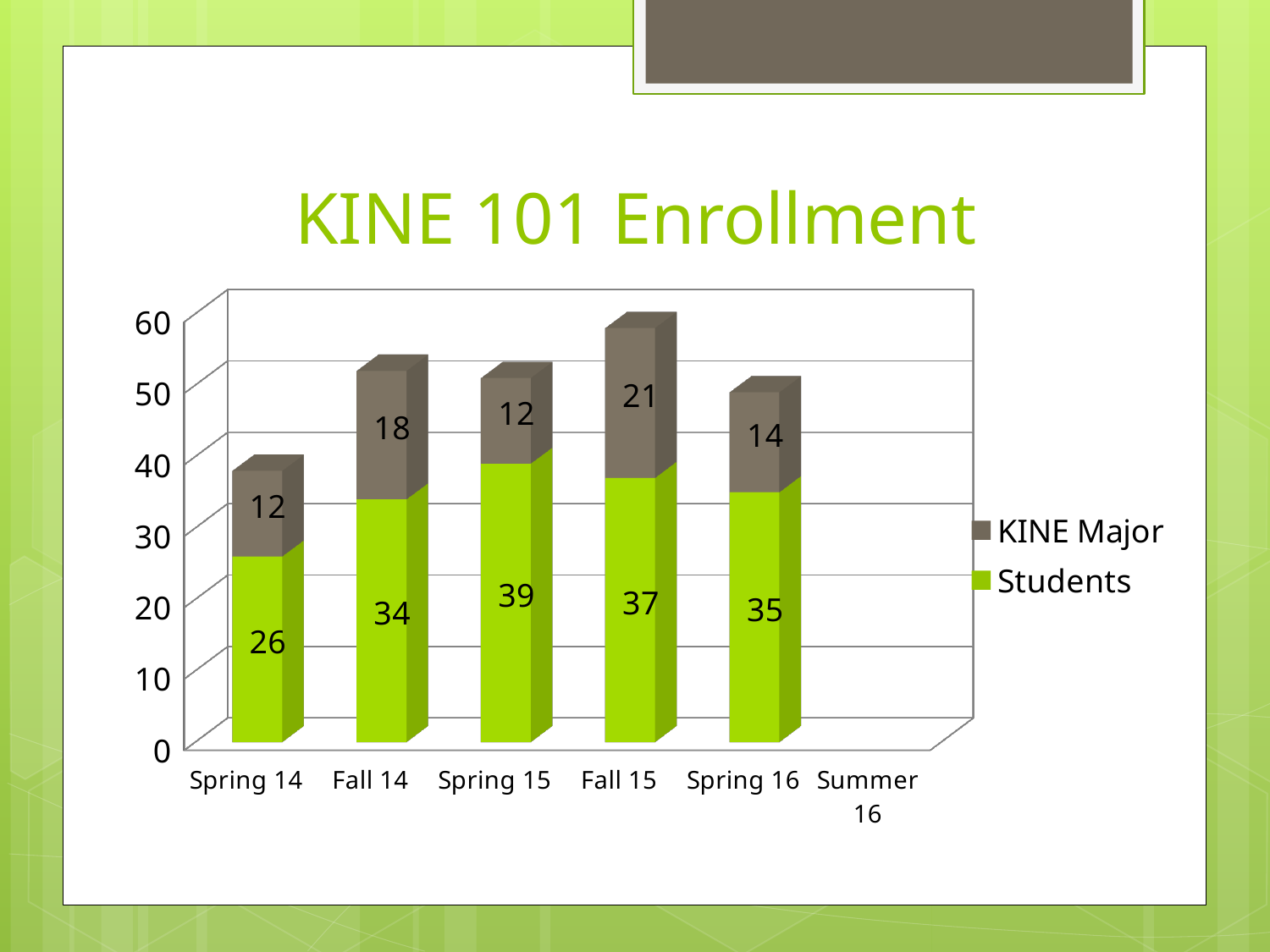
What is the total of the stacked bar for Fall 15? 58 What is the title of the chart? KINE 101 Enrollment What is the difference between the KINE Major values for Fall 15 and Spring 16? 7 Which is larger, the KINE Major value for Fall 14 or for Spring 15? Fall 14 What is the Students value for Spring 16? 35 What kind of chart is shown? Stacked bar chart What is the Students value for Spring 14? 26 Which semester has the lowest Students value? Spring 14 Which semester has the highest Students value? Spring 15 What is the KINE Major value for Fall 15? 21 How many series does the legend list? 2 Which semester has the highest KINE Major value? Fall 15